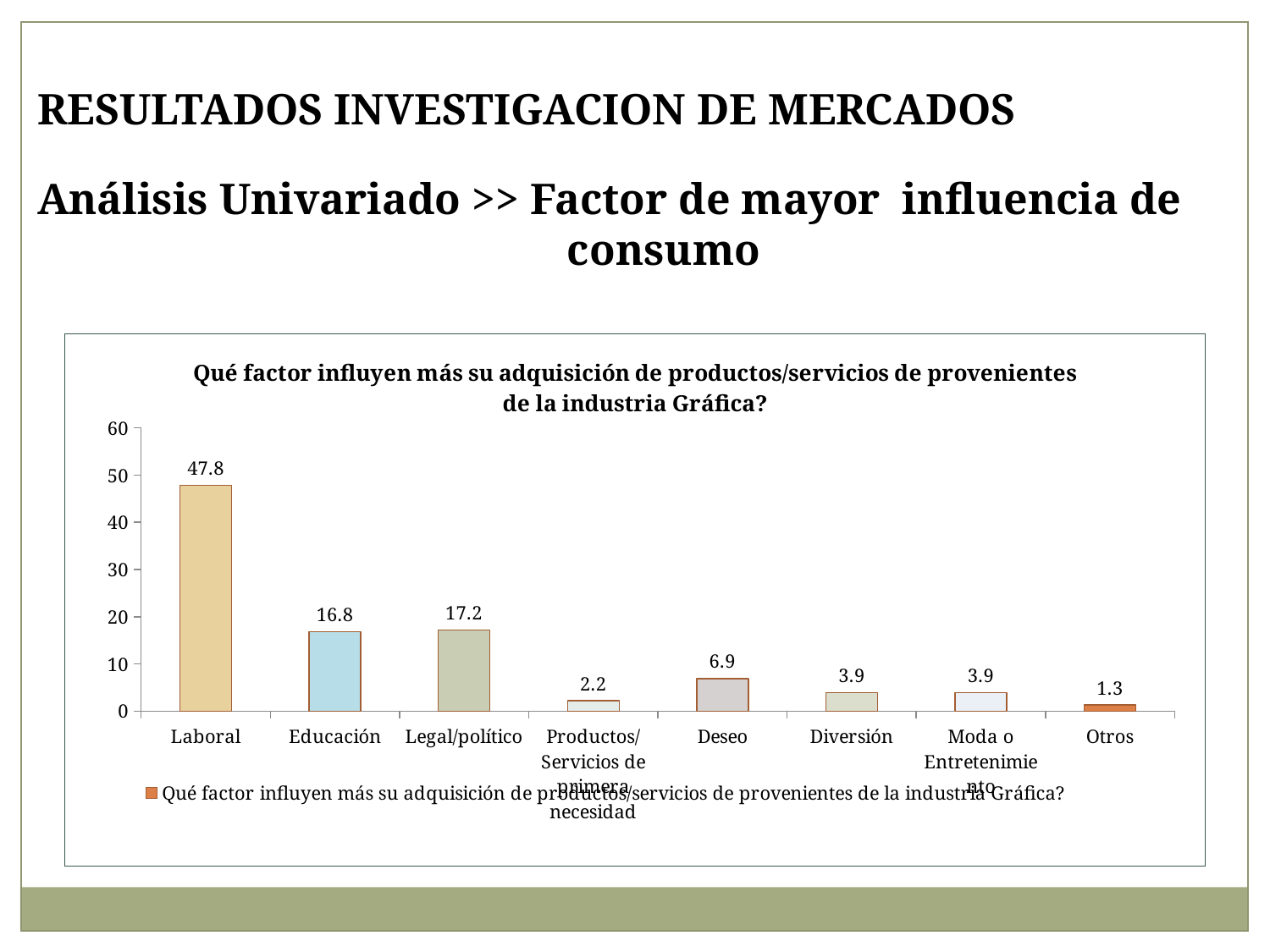
What is the value for Deseo? 6.9 What is the value for Laboral? 47.8 Which category has the lowest value? Otros Which is larger, the value for Educación or the value for Legal/político? Legal/político What is the difference between the values for Laboral and Legal/político? 30.6 What kind of chart is shown on the slide? Bar chart What is the title of the chart? Qué factor influyen más su adquisición de productos/servicios de provenientes de la industria Gráfica? What is the value for Educación? 16.8 What is the value for Otros? 1.3 How many categories are shown on the x axis? 8 Which category has the highest value? Laboral What is the difference between the values for Deseo and Diversión? 3